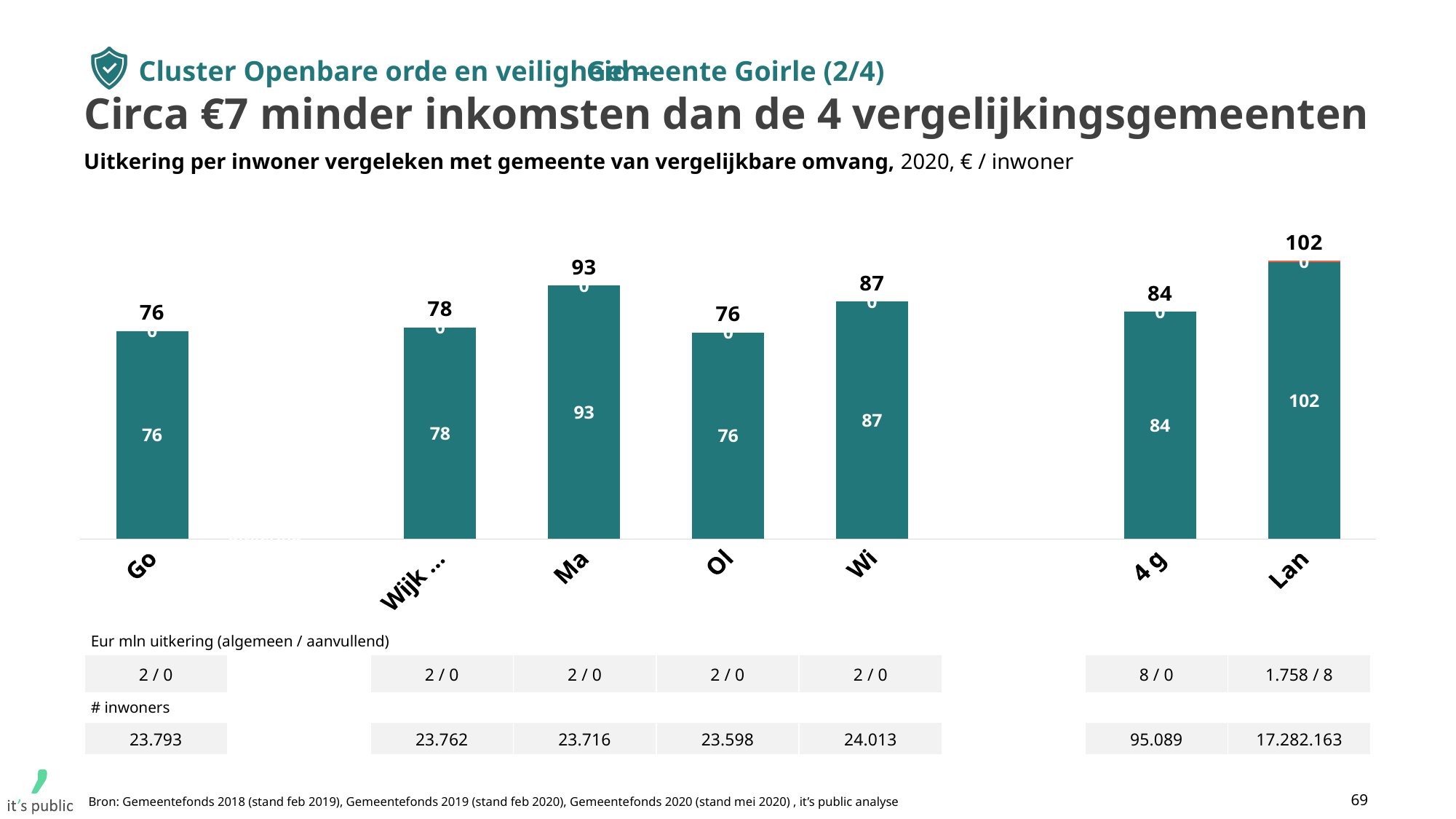
What kind of chart is shown on the slide? bar chart What is the value for Go? 76 What is the value for Lan? 102 How many bars are shown in the chart? 7 What is the value for Ma? 93 What unit is stated in the chart subtitle for the values? € / inwoner What is the difference between the values for Lan and 4 g? 18 Which is larger, the value for Wi or the value for Wijk ...? Wi What is the difference between the values for Ma and Go? 17 What is the value for Ol? 76 Which category has the highest value? Lan What is the value for 4 g? 84